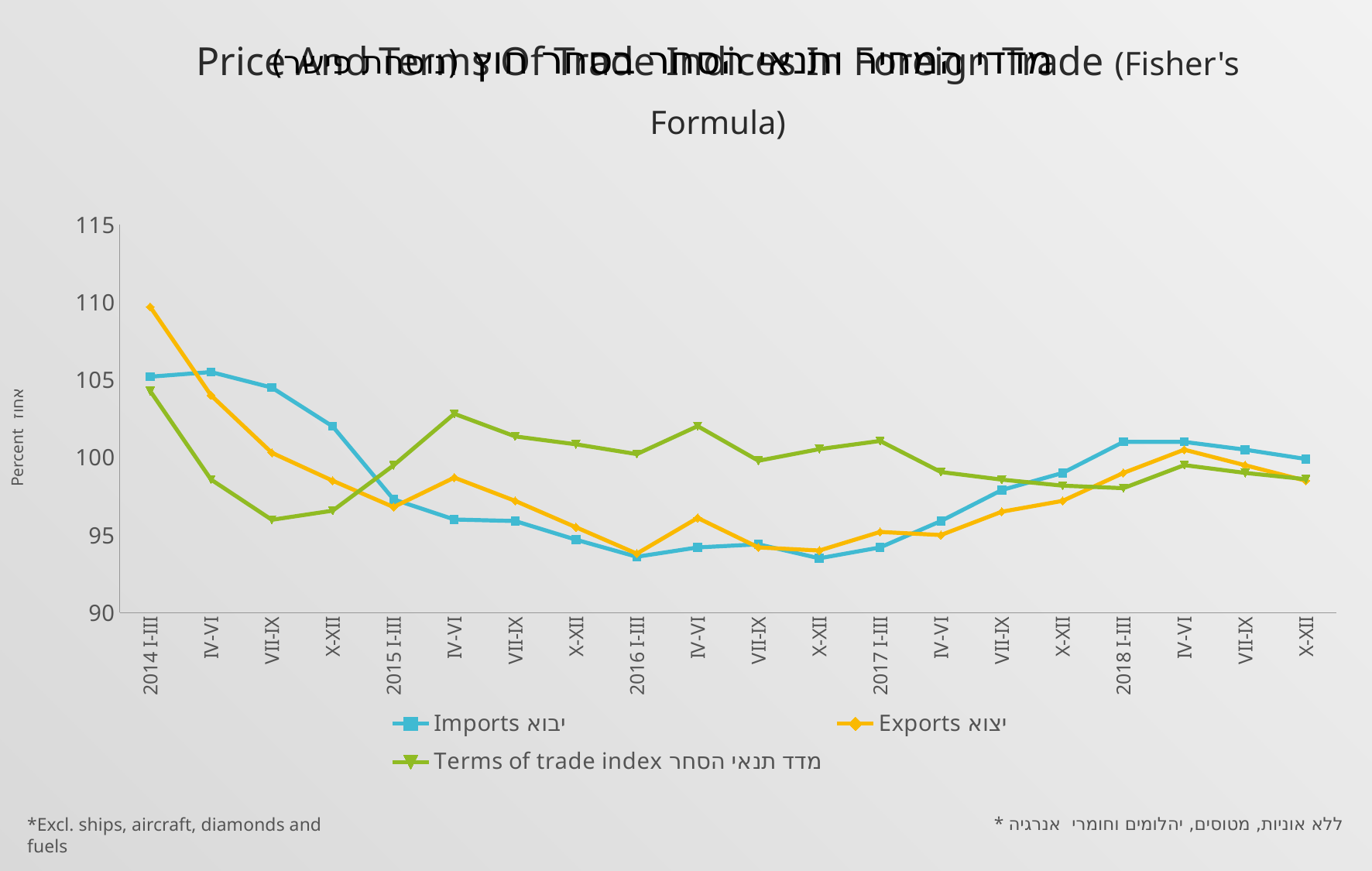
What kind of chart is shown on the slide? Line chart In 2014 I-III, which is higher: Imports or Exports? Exports In 2015 IV-VI, which is higher: Imports or the Terms of trade index? Terms of trade index How many series does the legend list? 3 Does the Exports series rise or fall from 2014 I-III to 2015 I-III? Fall Is the value for the Terms of trade index in 2015 IV-VI greater or less than 100? greater Is the value for Exports in 2016 I-III greater or less than 95? less Is the value for Imports in 2016 X-XII greater or less than 95? less In which period does the Exports series reach its highest value? 2014 I-III How many time periods are plotted along the x axis? 20 What is the label on the vertical axis? Percent אחוז